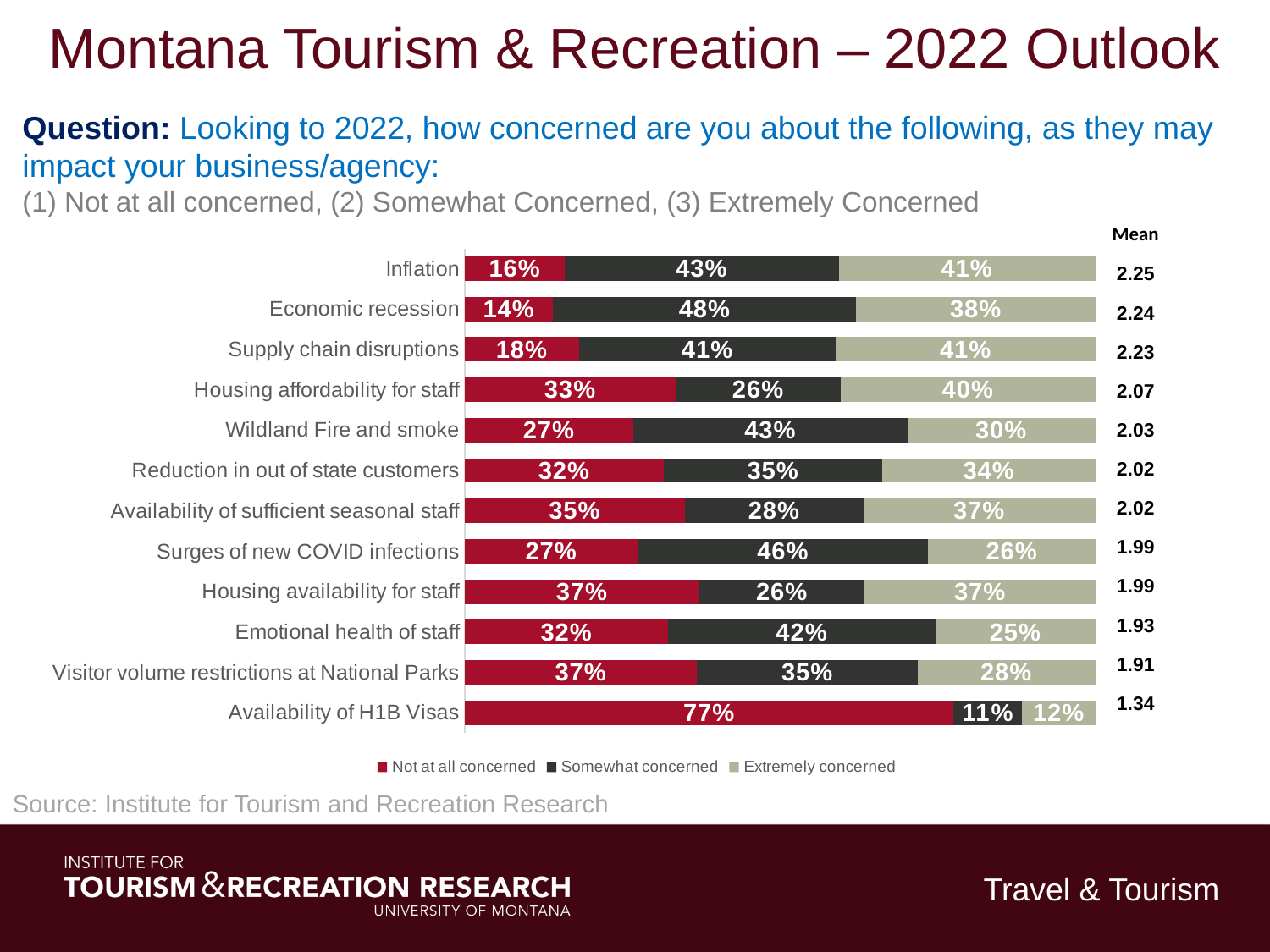
What percentage of respondents were 'Not at all concerned' about Availability of H1B Visas? 77% What is the difference between the 'Somewhat concerned' percentages for Surges of new COVID infections and Housing availability for staff? 20% What percentage of respondents were 'Somewhat concerned' about Economic recession? 48% How many categories are shown in the chart? 12 Which category has the lowest 'Extremely concerned' percentage? Availability of H1B Visas How many series does the legend list? 3 Which category has the highest 'Not at all concerned' percentage? Availability of H1B Visas What is the Mean value shown for Inflation? 2.25 Which is larger: the 'Extremely concerned' percentage for Housing affordability for staff or for Wildland Fire and smoke? Housing affordability for staff What percentage of respondents were 'Extremely concerned' about Inflation? 41% Which colour represents 'Extremely concerned' in the legend? Grey-green What kind of chart is shown on the slide? Stacked bar chart